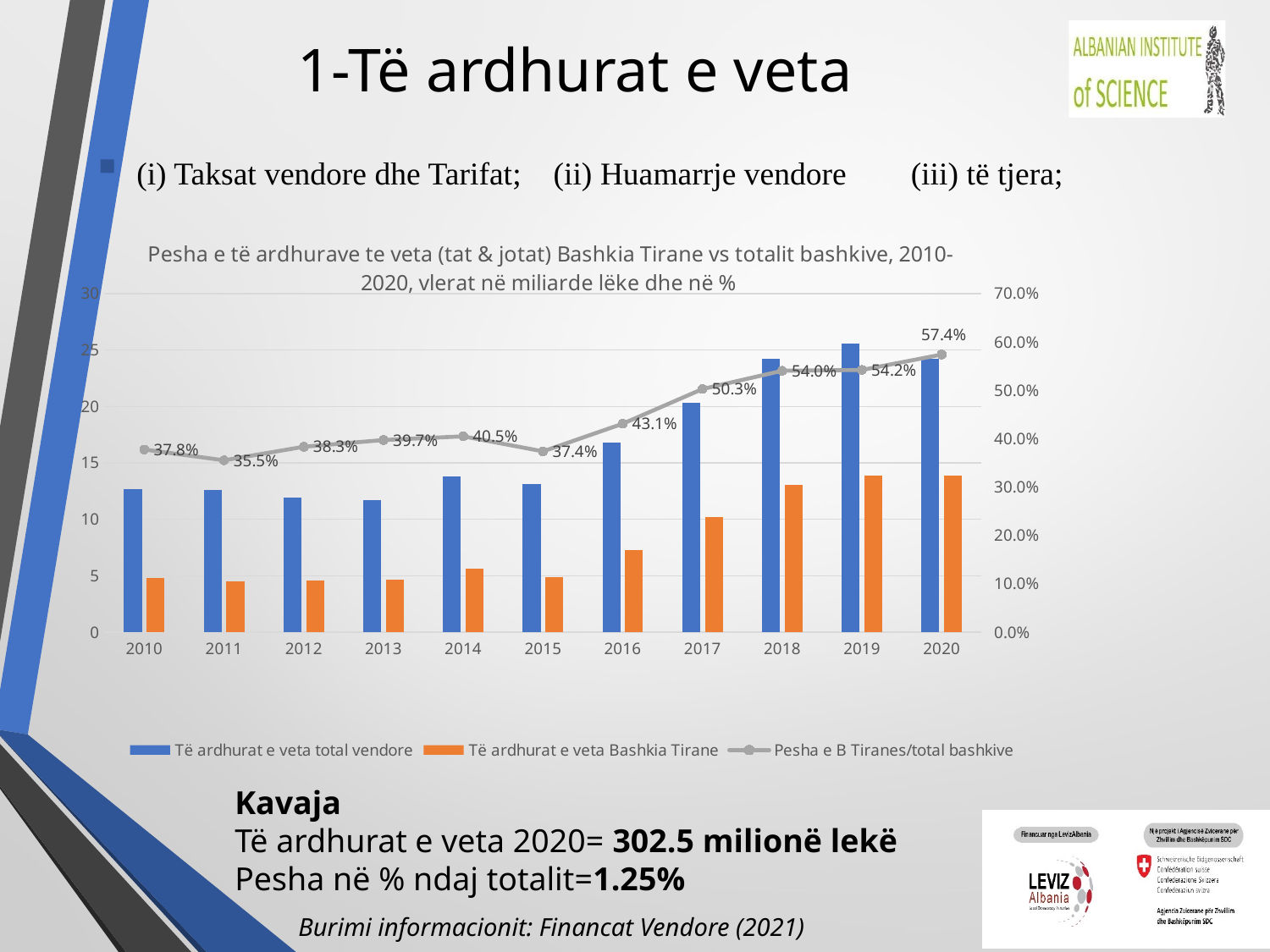
Which year has a higher Pesha e B Tiranes/total bashkive value, 2014 or 2015? 2014 In which year is Pesha e B Tiranes/total bashkive highest? 2020 How many years are shown on the x axis of the chart? 11 What is the value of Pesha e B Tiranes/total bashkive for 2020? 57.4% In which year is Pesha e B Tiranes/total bashkive lowest? 2011 What is the value of Pesha e B Tiranes/total bashkive for 2011? 35.5% Is the value of Të ardhurat e veta Bashkia Tirane for 2010 greater or less than 10? less Does Pesha e B Tiranes/total bashkive rise or fall from 2015 to 2020? rise What is the difference between the Pesha e B Tiranes/total bashkive values for 2020 and 2010? 19.6% Is the value of Të ardhurat e veta total vendore for 2019 greater or less than 20? greater How many series does the chart legend list? 3 What is the value of Pesha e B Tiranes/total bashkive for 2017? 50.3%